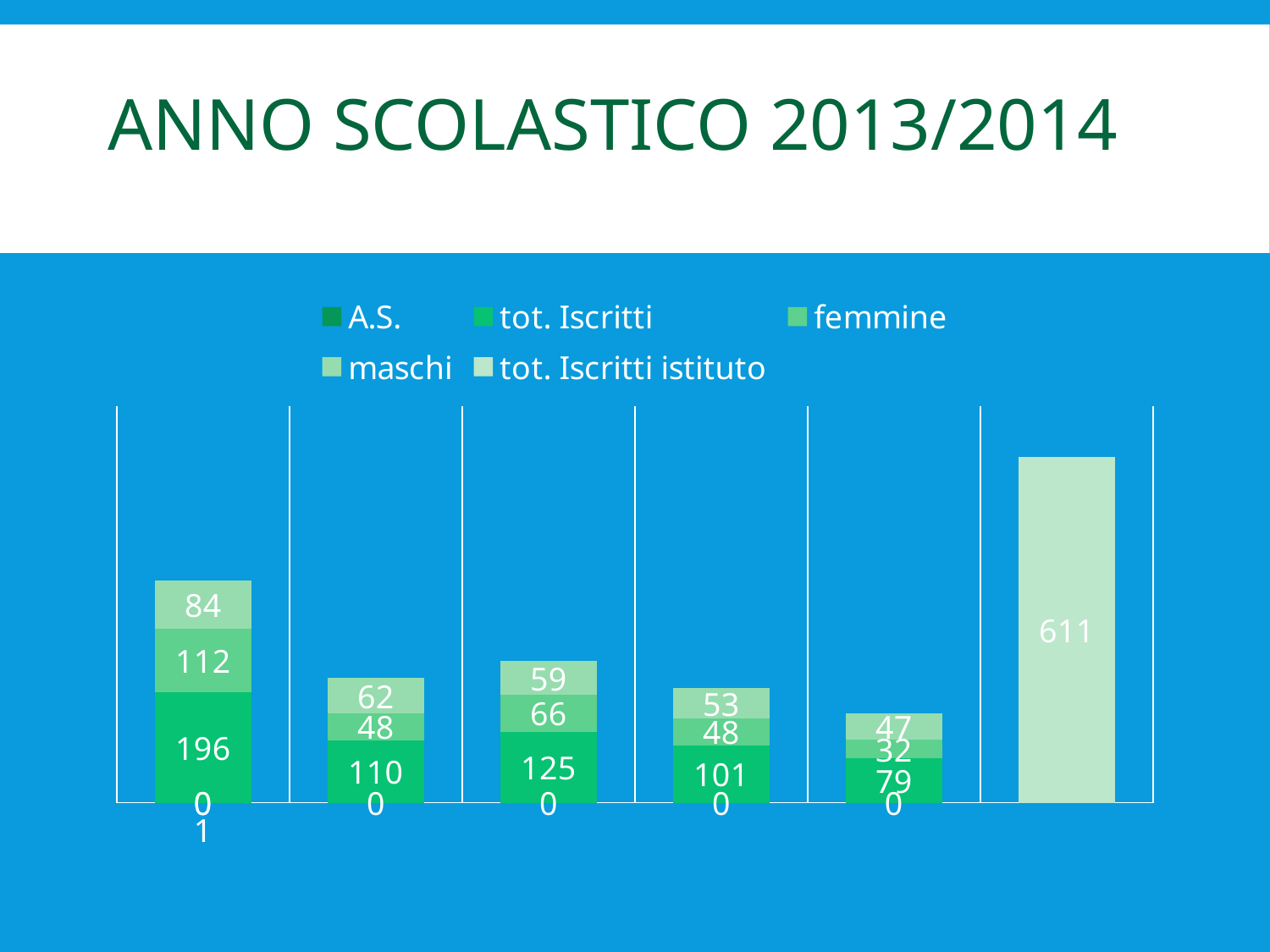
What kind of chart is shown on the slide? bar chart How many bars are plotted in the chart? 6 How many series does the legend list? 5 What is the 'femmine' value in the first (leftmost) bar? 112 In the second bar, what is the difference between 'maschi' and 'femmine'? 14 What is the total of the stacked segments in the first (leftmost) bar? 392 In the first (leftmost) bar, which is larger: 'femmine' or 'maschi'? femmine What is the difference between the 'tot. Iscritti' values of the first bar and the second bar? 86 What is the value of the 'tot. Iscritti istituto' bar? 611 What is the 'tot. Iscritti' value in the first (leftmost) bar? 196 Which bar has the highest 'tot. Iscritti' value? the first (leftmost) bar Which bar has the lowest 'tot. Iscritti' value? the fifth bar